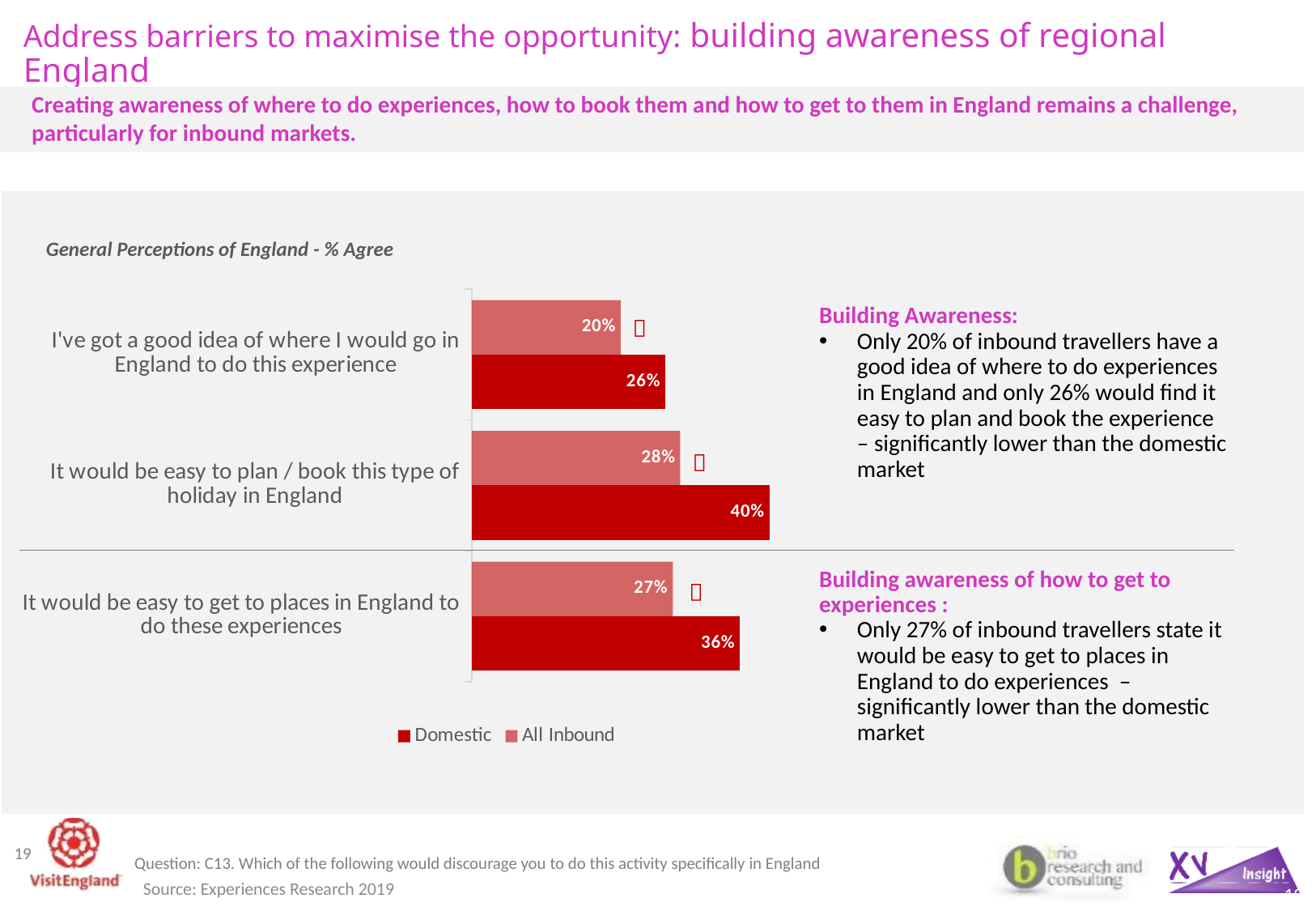
What is the difference between the Domestic and All Inbound values for "It would be easy to plan / book this type of holiday in England"? 12% What is the Domestic value for "It would be easy to plan / book this type of holiday in England"? 40% What kind of chart is shown on the slide? Bar chart What is the difference between the Domestic and All Inbound values for "It would be easy to get to places in England to do these experiences"? 9% What is the All Inbound value for "It would be easy to get to places in England to do these experiences"? 27% What is the All Inbound value for "I've got a good idea of where I would go in England to do this experience"? 20% Which is larger for "I've got a good idea of where I would go in England to do this experience": the Domestic value or the All Inbound value? Domestic How many categories are shown in the chart? 3 Which category has the lowest All Inbound value? I've got a good idea of where I would go in England to do this experience What is the Domestic value for "I've got a good idea of where I would go in England to do this experience"? 26% Which category has the highest Domestic value? It would be easy to plan / book this type of holiday in England How many series does the legend list? 2